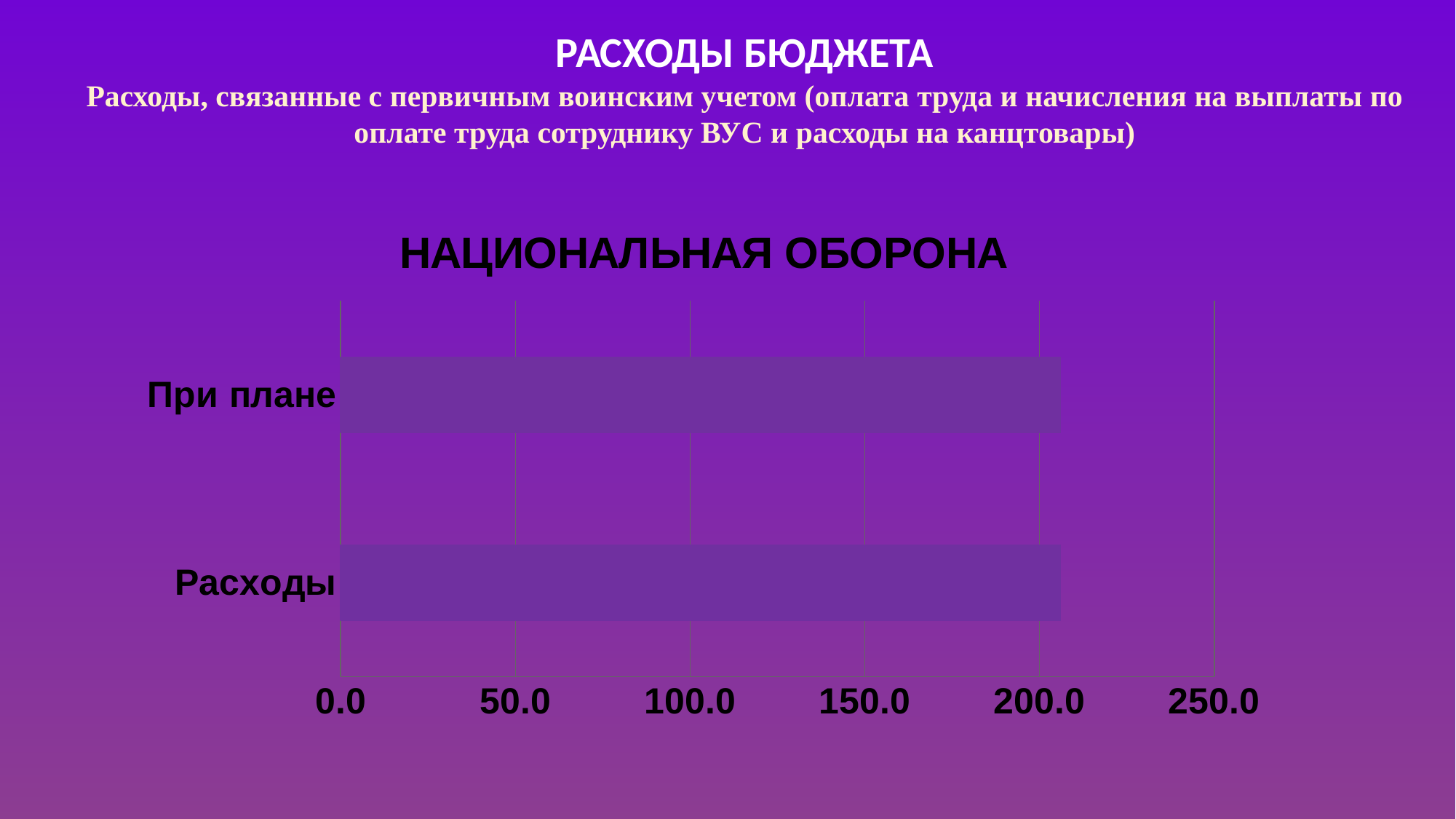
Is the value for При плане greater or less than 250.0? less How many categories are plotted in the chart? 2 What is the title of the chart? НАЦИОНАЛЬНАЯ ОБОРОНА Is the value for Расходы greater or less than 100.0? greater What kind of chart is shown on the slide? bar chart Which category is listed at the top of the chart? При плане Is the value for При плане greater or less than 150.0? greater What is the highest value shown on the horizontal axis? 250.0